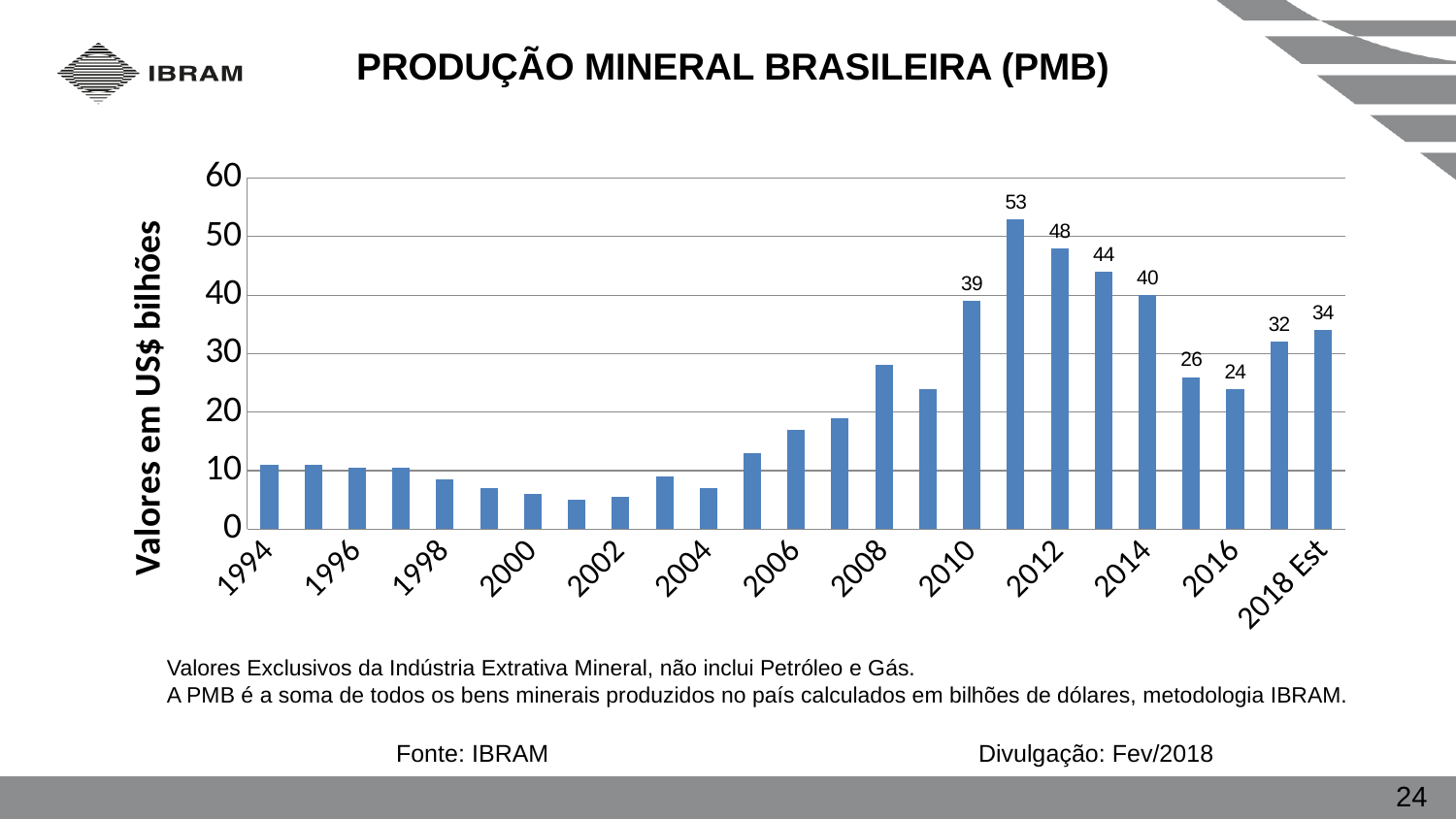
What kind of chart is shown on the slide? bar chart Is the value for 2008 greater or less than 20? greater What is the value for 2011? 53 Is the value for 2002 greater or less than 10? less What is the value for 2016? 24 What is the value for 2018 Est? 34 Do the values rise or fall from 2011 to 2016? fall What is the difference between the values for 2011 and 2012? 5 Which is larger, the value for 2016 or the value for 2017? 2017 What is the title of the vertical axis? Valores em US$ bilhões Which year has the highest value? 2011 How many bars are plotted in the chart? 25